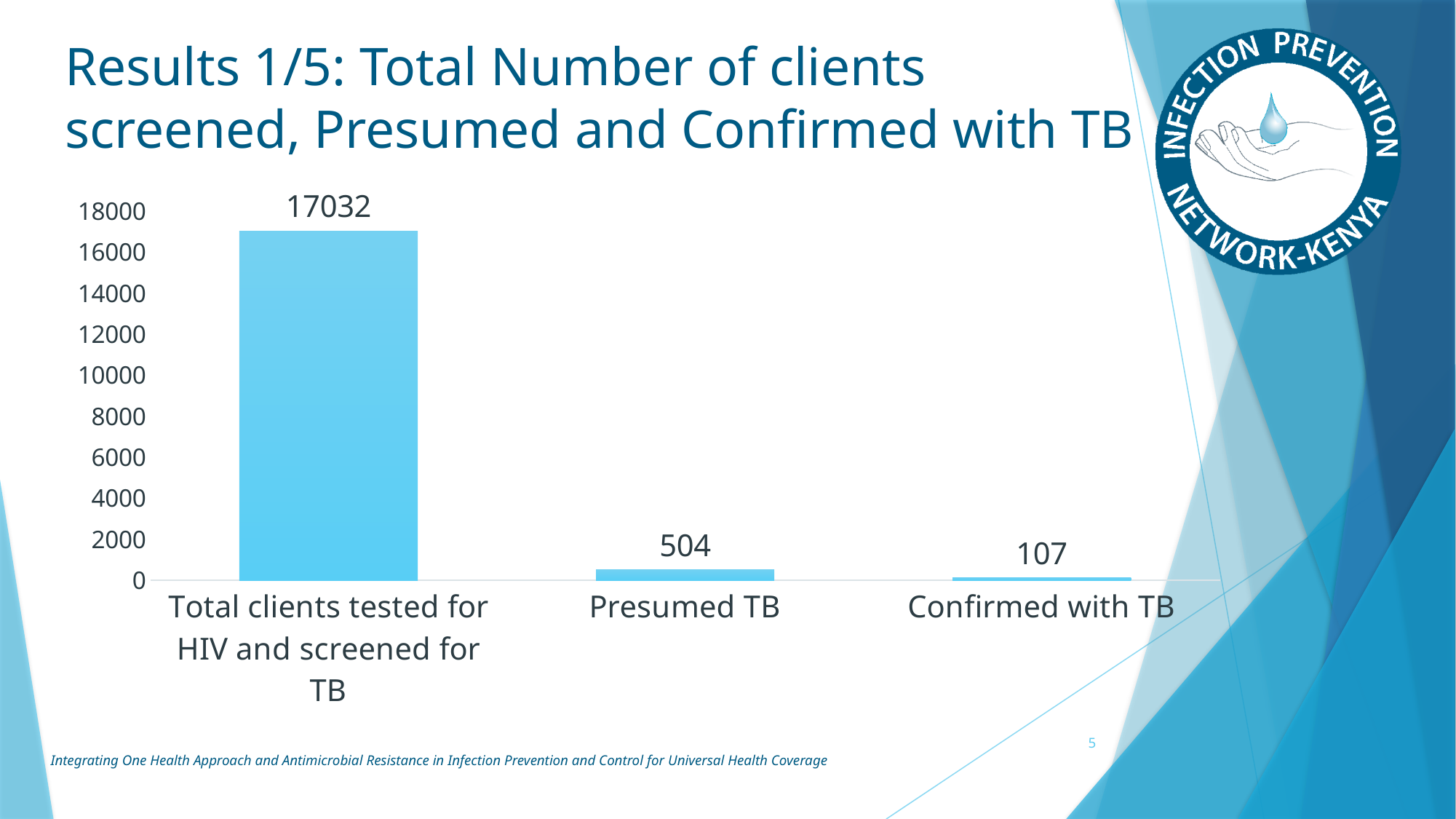
What is the value for Confirmed with TB? 107 Which is larger, the value for Presumed TB or the value for Confirmed with TB? Presumed TB Do the values rise or fall from left to right along the x axis? fall What is the value for Presumed TB? 504 Which category has the lowest value? Confirmed with TB What is the value for Total clients tested for HIV and screened for TB? 17032 What kind of chart is shown on the slide? bar chart What is the difference between the values for Total clients tested for HIV and screened for TB and Presumed TB? 16528 How many categories are shown on the chart? 3 Is the value for Total clients tested for HIV and screened for TB greater or less than 16000? greater What is the difference between the values for Presumed TB and Confirmed with TB? 397 Which category has the highest value? Total clients tested for HIV and screened for TB